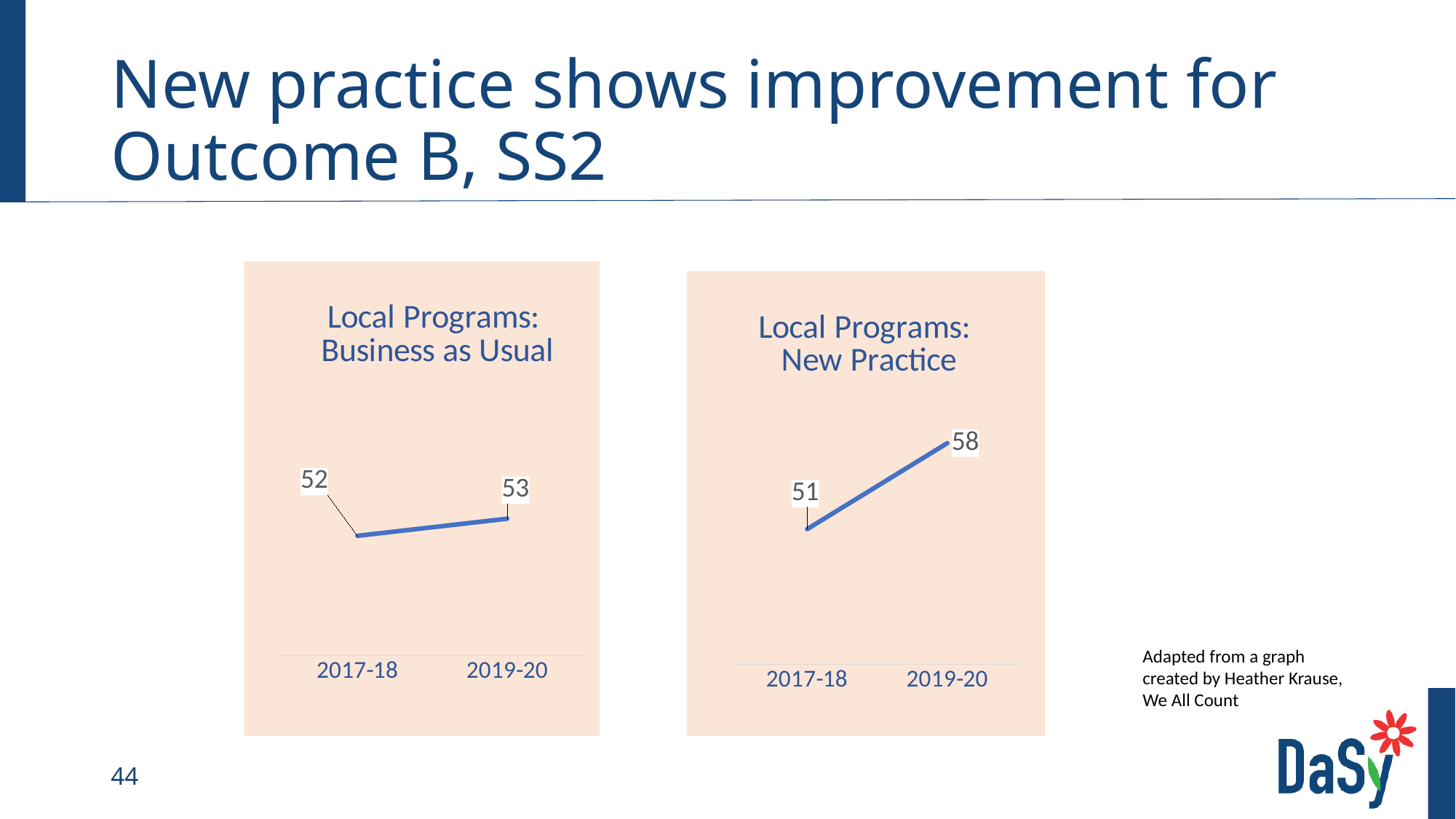
In the 'Local Programs: New Practice' chart, which year has the highest value? 2019-20 What is the title of the chart on the right of the slide? Local Programs: New Practice What kind of chart is the 'Local Programs: Business as Usual' chart? line chart In the 'Local Programs: New Practice' chart, what is the value for 2019-20? 58 In the 'Local Programs: New Practice' chart, what is the value for 2017-18? 51 In the 'Local Programs: New Practice' chart, do the values rise or fall from 2017-18 to 2019-20? rise In the 'Local Programs: New Practice' chart, what is the difference between the 2019-20 and 2017-18 values? 7 In the 'Local Programs: Business as Usual' chart, what is the value for 2019-20? 53 In the 'Local Programs: Business as Usual' chart, what is the value for 2017-18? 52 Which chart has the higher value for 2019-20, 'Local Programs: Business as Usual' or 'Local Programs: New Practice'? Local Programs: New Practice In the 'Local Programs: Business as Usual' chart, what is the difference between the 2019-20 and 2017-18 values? 1 How many data points are plotted in the 'Local Programs: New Practice' chart? 2